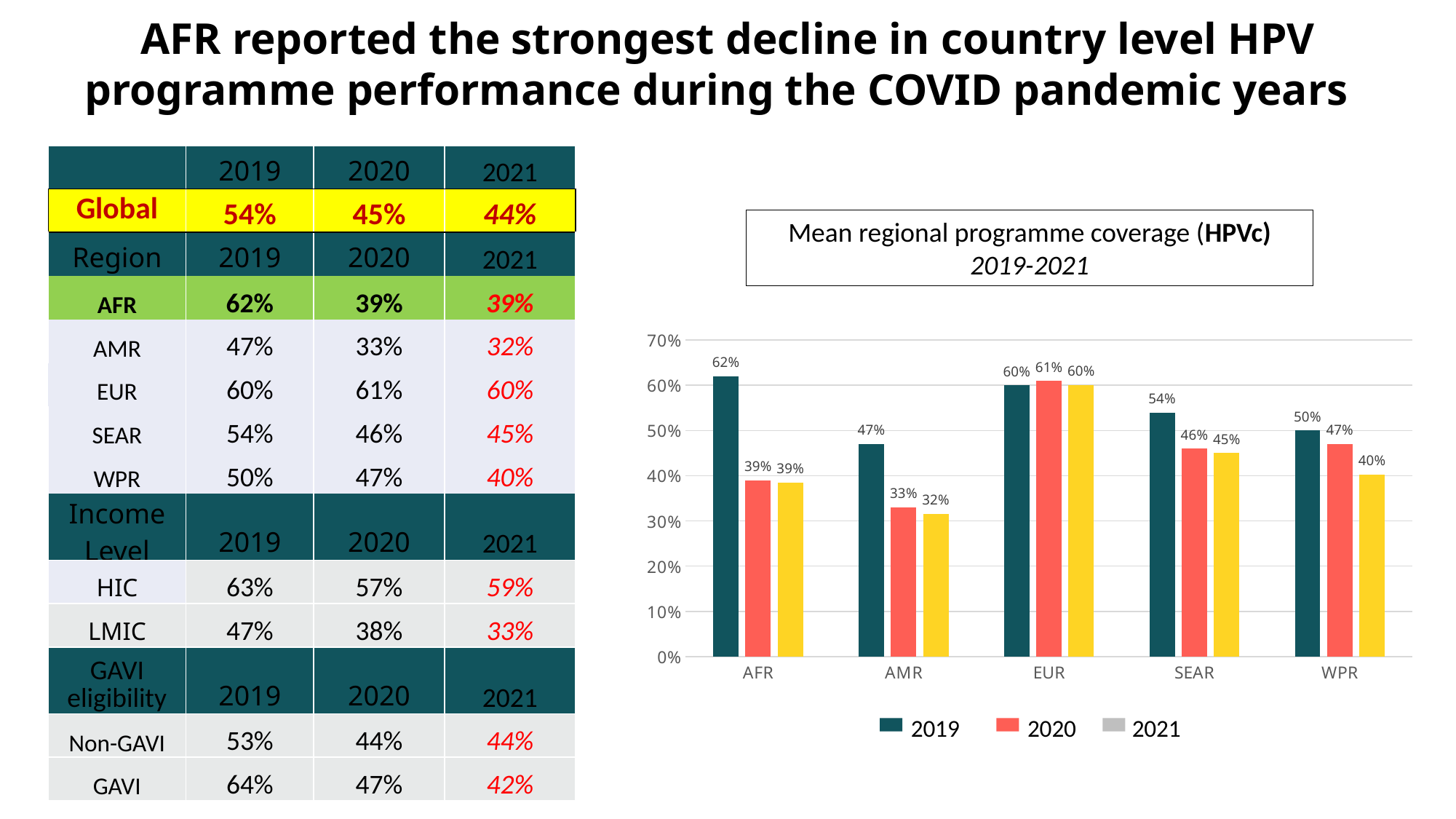
What is the 2019 value for AFR in the chart? 62% What is the title of the chart? Mean regional programme coverage (HPVc) 2019-2021 Do the values for AMR rise or fall from 2019 to 2021? Fall Which region has the lowest 2021 value in the chart? AMR What is the 2021 value for WPR in the chart? 40% Which is larger for SEAR: the 2019 value or the 2021 value? 2019 How many series does the chart legend list? 3 What is the 2020 value for EUR in the chart? 61% Which region has the highest 2019 value in the chart? AFR What kind of chart is shown on the slide? Bar chart How many regions are shown on the x axis of the chart? 5 What is the difference between the 2019 and 2020 values for AFR? 23%